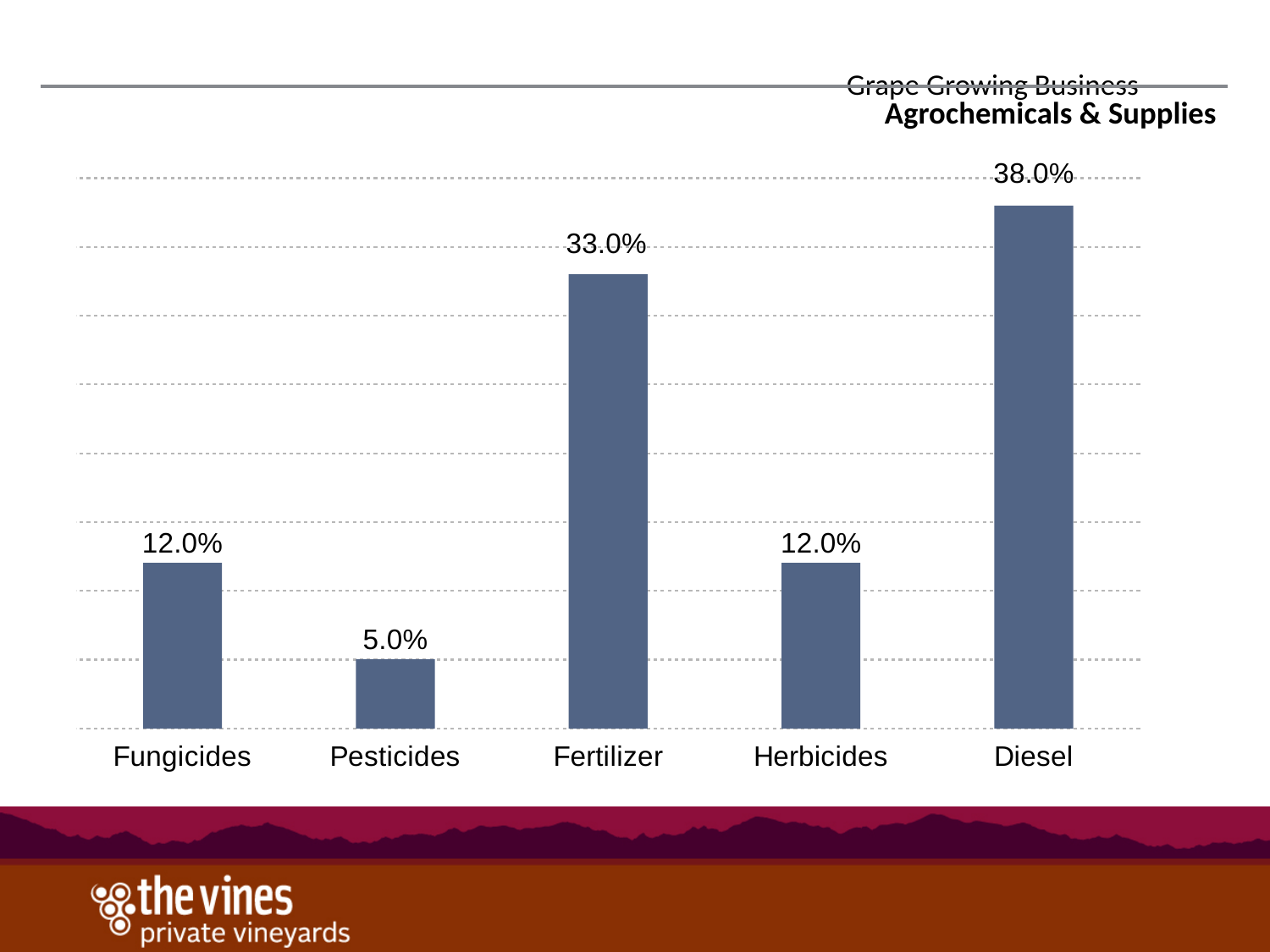
What kind of chart is shown on the slide? Bar chart What is the value for Herbicides? 12.0% What is the difference between the values for Fungicides and Pesticides? 7.0% What is the title of the chart? Agrochemicals & Supplies What is the value for Pesticides? 5.0% How many categories are shown on the x axis? 5 Which category has the lowest value? Pesticides Which category has the highest value? Diesel What is the value for Fertilizer? 33.0% What is the value for Diesel? 38.0% Which is larger, the value for Fertilizer or the value for Herbicides? Fertilizer What is the difference between the values for Diesel and Fertilizer? 5.0%